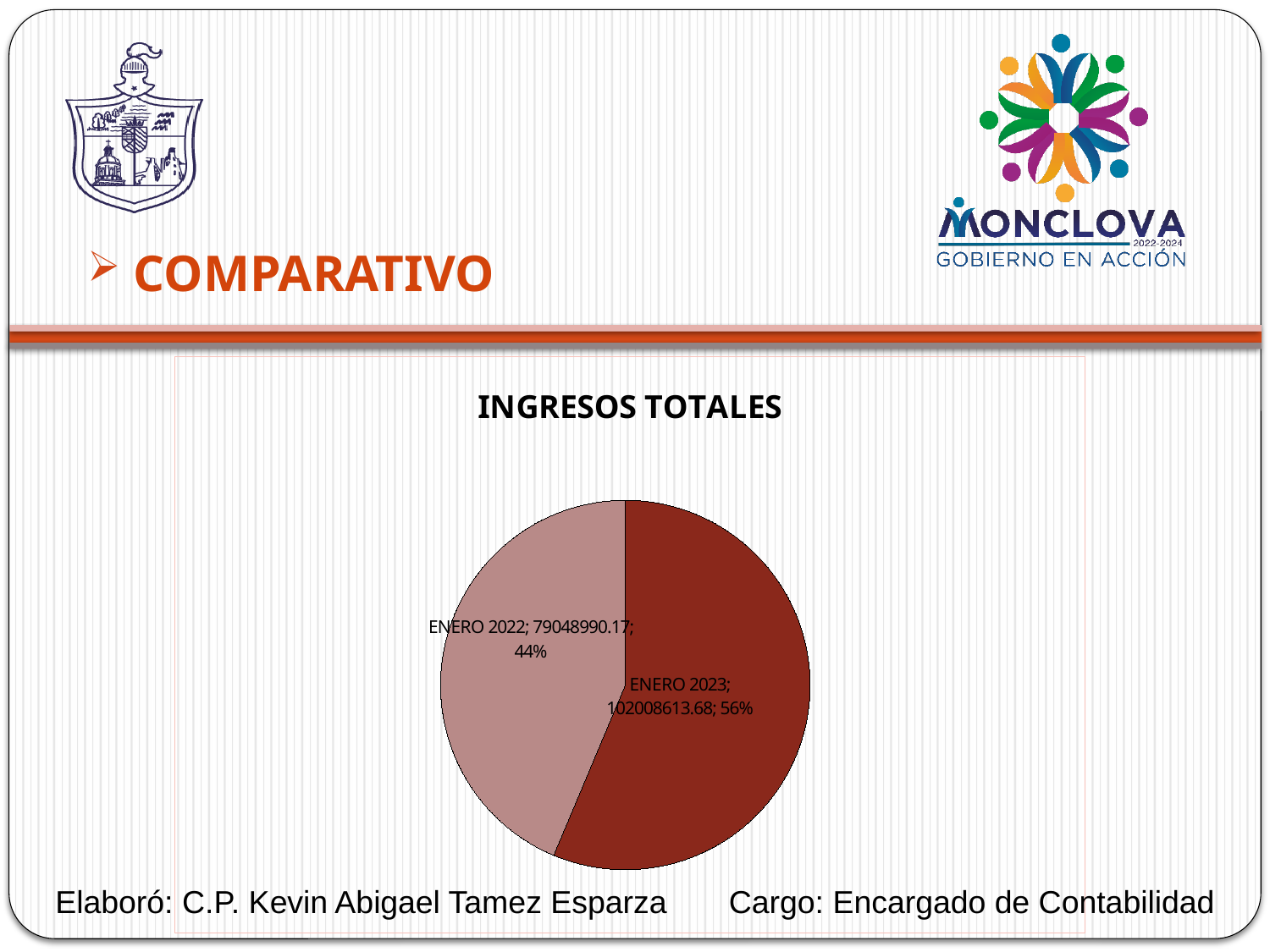
What is the value for ENERO 2022? 79048990.17 What is the value for ENERO 2023? 102008613.68 Which is larger, the value for ENERO 2022 or ENERO 2023? ENERO 2023 Which category has the smallest slice? ENERO 2022 What kind of chart is shown on the slide? pie chart What is the total of the two values shown in the pie chart? 181057603.85 What share of the pie does ENERO 2022 represent? 44% How many slices does the pie chart have? 2 What share of the pie does ENERO 2023 represent? 56% What is the difference between the values for ENERO 2023 and ENERO 2022? 22959623.51 Which category has the largest slice? ENERO 2023 What is the title of the chart? INGRESOS TOTALES